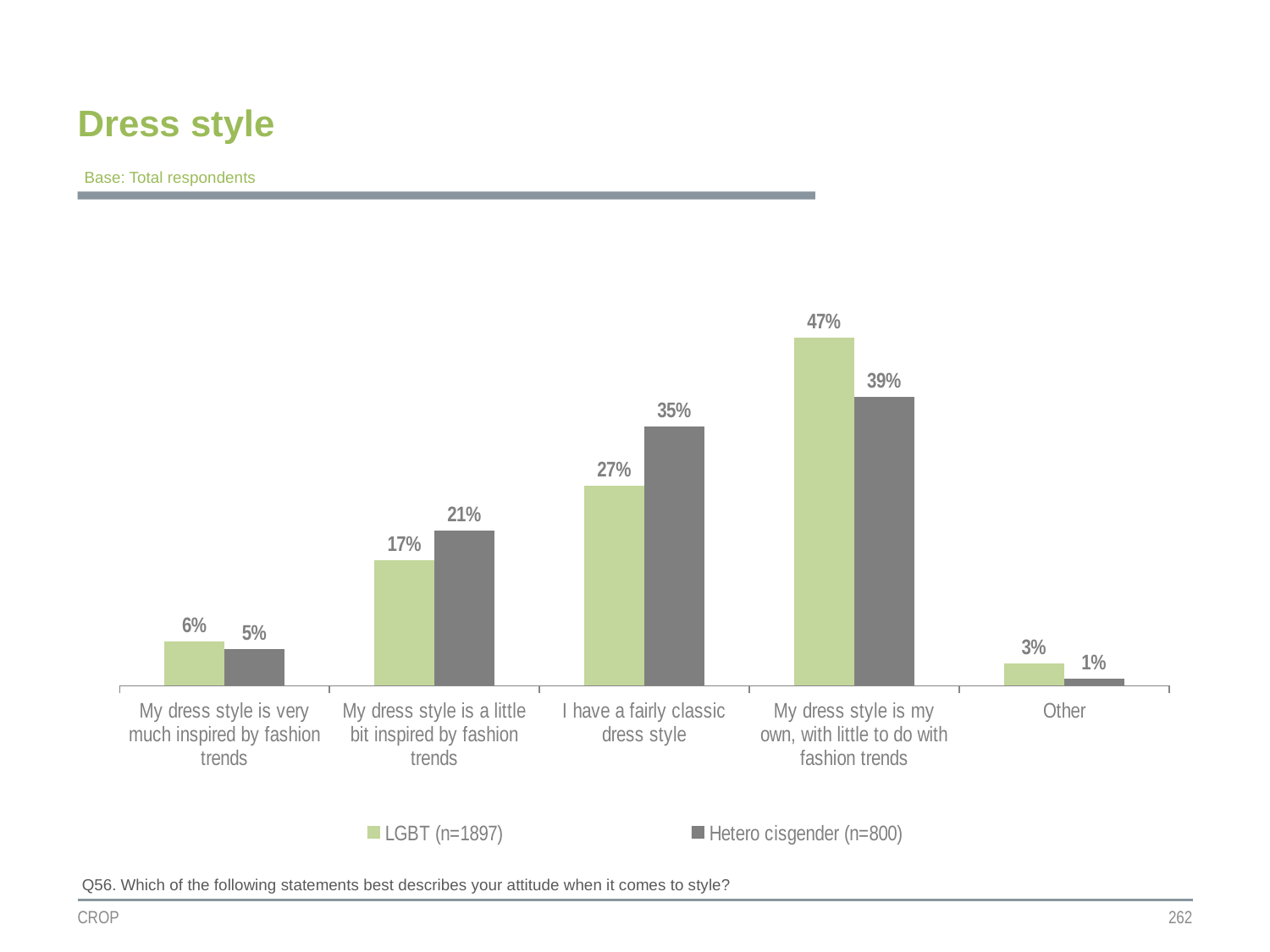
What percentage of Hetero cisgender respondents said they have a fairly classic dress style? 35% What is the sample size for the Hetero cisgender group shown in the legend? n=800 Which category has the highest value for Hetero cisgender respondents? My dress style is my own, with little to do with fashion trends What is the difference between the LGBT and Hetero cisgender values for 'My dress style is my own, with little to do with fashion trends'? 8 percentage points How many categories are shown on the x axis? 5 What is the value for LGBT respondents for 'My dress style is a little bit inspired by fashion trends'? 17% What is the difference between the Hetero cisgender and LGBT values for 'I have a fairly classic dress style'? 8 percentage points Which category has the lowest value for LGBT respondents? Other What kind of chart is shown on the slide? Bar chart For 'My dress style is a little bit inspired by fashion trends', which group has the larger value? Hetero cisgender (n=800) How many series does the legend list? 2 What percentage of LGBT respondents said their dress style is their own, with little to do with fashion trends? 47%